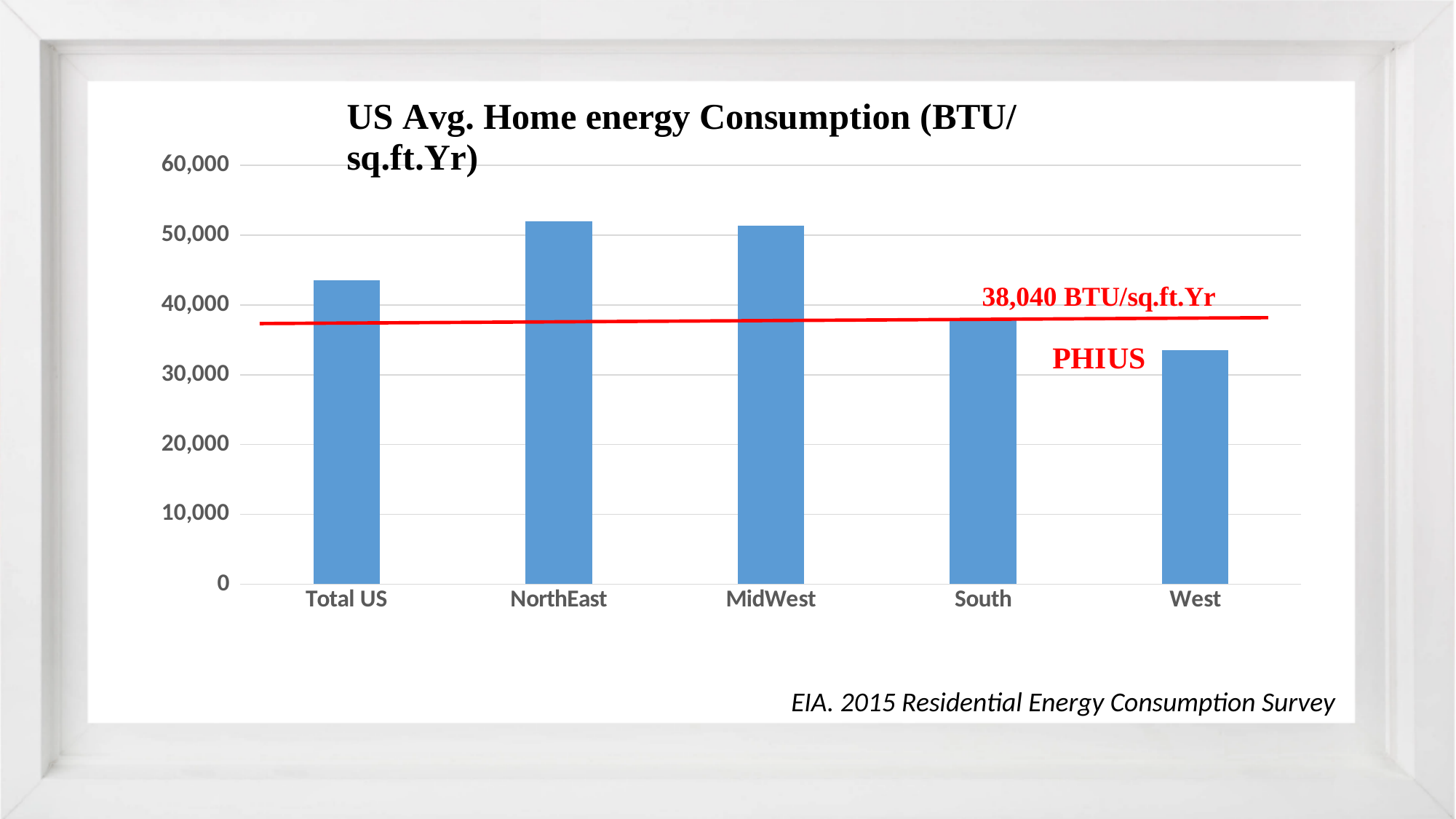
Is the value for MidWest greater or less than 50,000? greater How many categories are plotted on the x axis of the chart? 5 Is the value for Total US greater or less than 40,000? greater Which category has the lowest average home energy consumption? West What is the title of the chart? US Avg. Home energy Consumption (BTU/sq.ft.Yr) What value is marked by the red PHIUS reference line on the chart? 38,040 BTU/sq.ft.Yr Is the value for West greater or less than 40,000? less What kind of chart is shown on the slide? bar chart Which is larger, the value for Total US or the value for West? Total US Which is larger, the value for NorthEast or the value for South? NorthEast